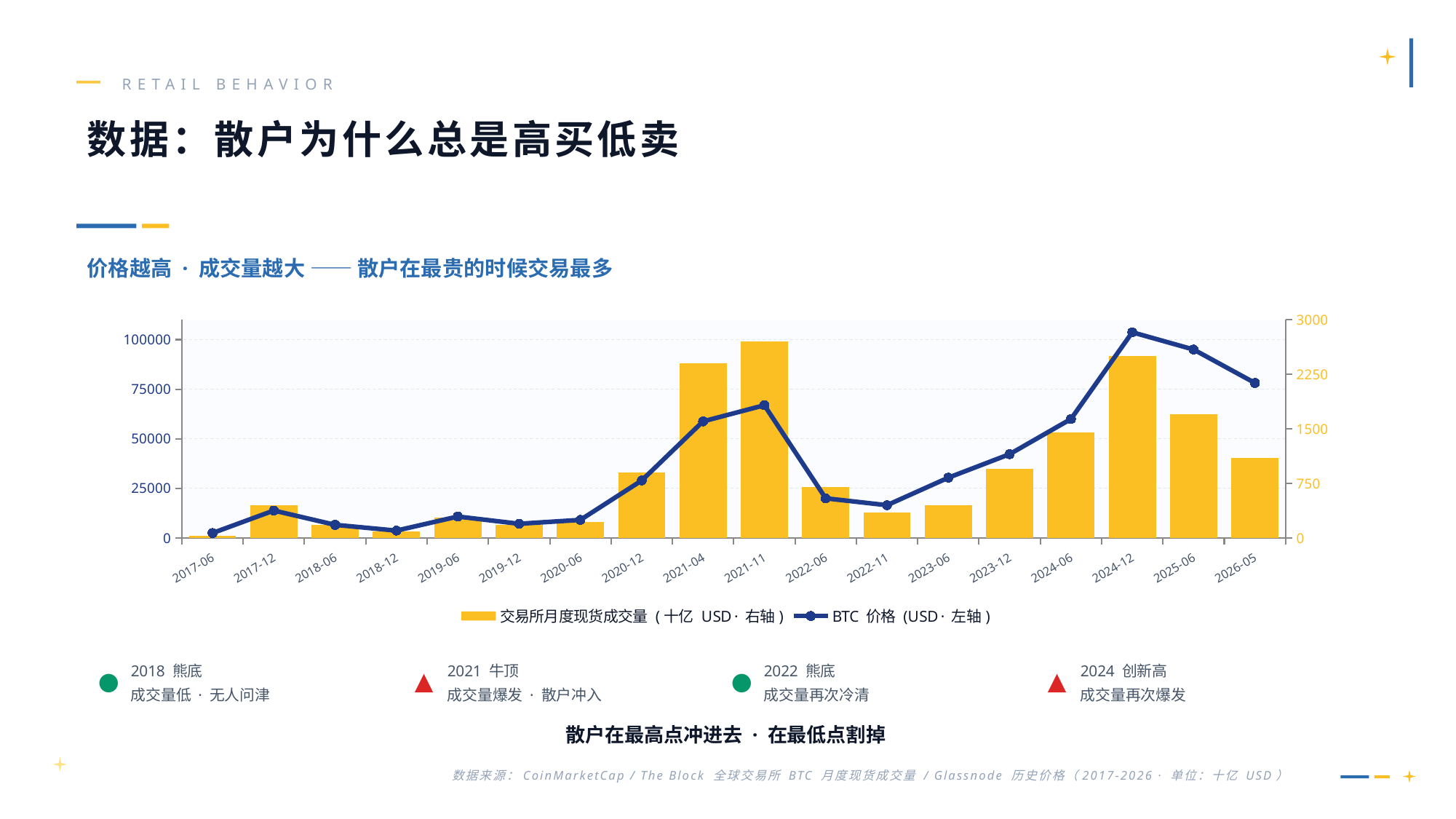
Is the BTC price at 2021-11 greater or less than 50000? greater How many time points are shown on the x axis of the chart? 18 Which has the larger trading volume bar, 2021-04 or 2021-11? 2021-11 How many series does the chart legend list? 2 Is the BTC price at 2022-11 greater or less than 25000? less At which time point does the BTC price line reach its highest value? 2024-12 Does the BTC price line rise or fall from 2024-12 to 2026-05? fall At which time point is the exchange monthly spot trading volume (bar) highest? 2021-11 Is the trading volume bar at 2021-11 greater or less than 2250? greater Which series is plotted on the right axis according to the legend? 交易所月度现货成交量（十亿 USD · 右轴） At which time point is the exchange monthly spot trading volume (bar) lowest? 2017-06 What kind of chart is shown on the slide? A combination bar and line chart